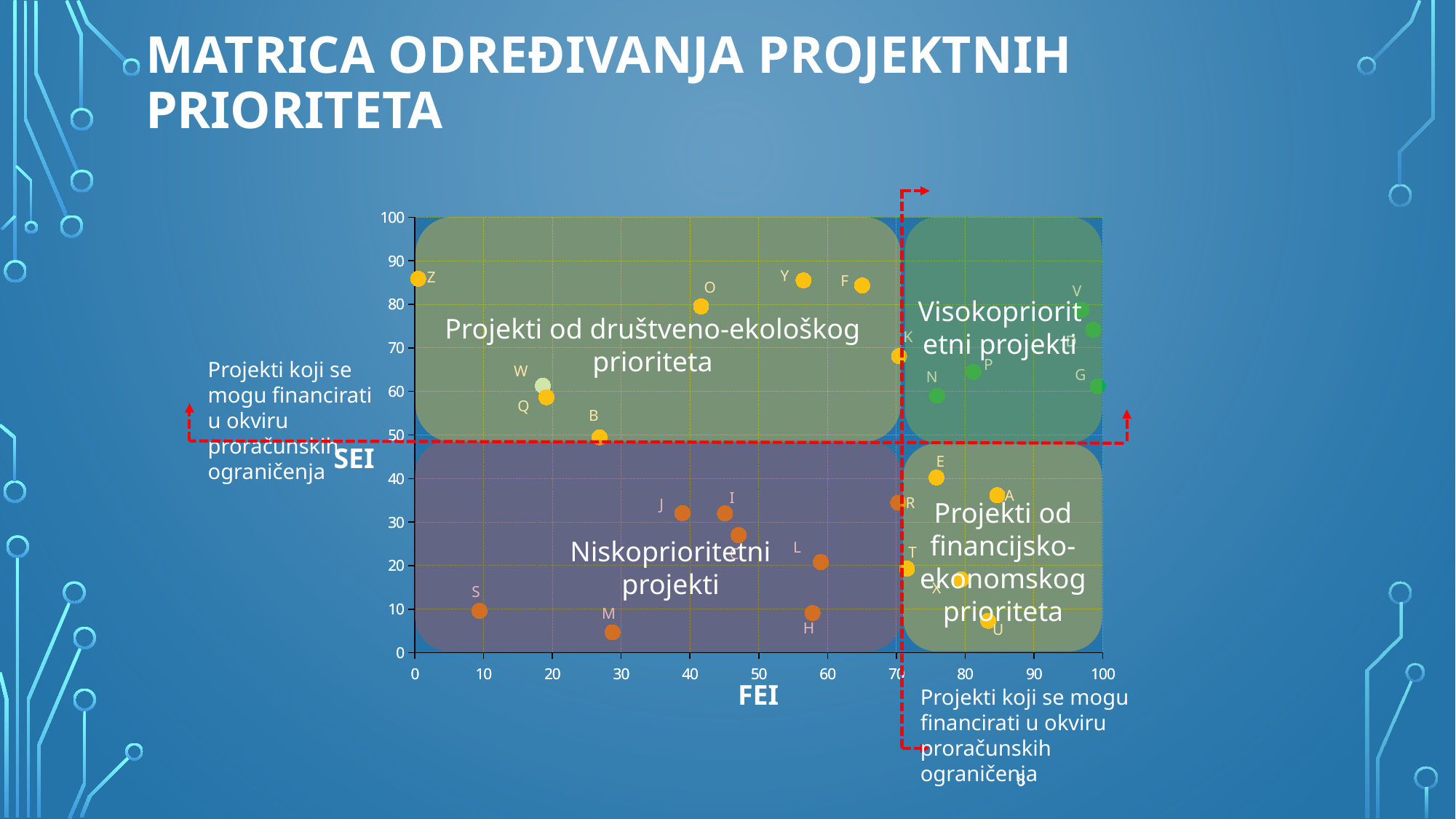
Which labelled point has the lowest FEI value? Z Which point has the higher SEI value, Z or M? Z Is the SEI value for point M greater or less than 10? less Is the FEI value for point G greater or less than 90? greater Is the SEI value for point E greater or less than 30? greater What is the label of the horizontal axis of the chart? FEI What kind of chart is shown on the slide? scatter chart Which labelled point has the lowest SEI value? M Which point has the higher FEI value, S or G? G Which quadrant label appears in the top-right area of the chart? Visokoprioritetni projekti